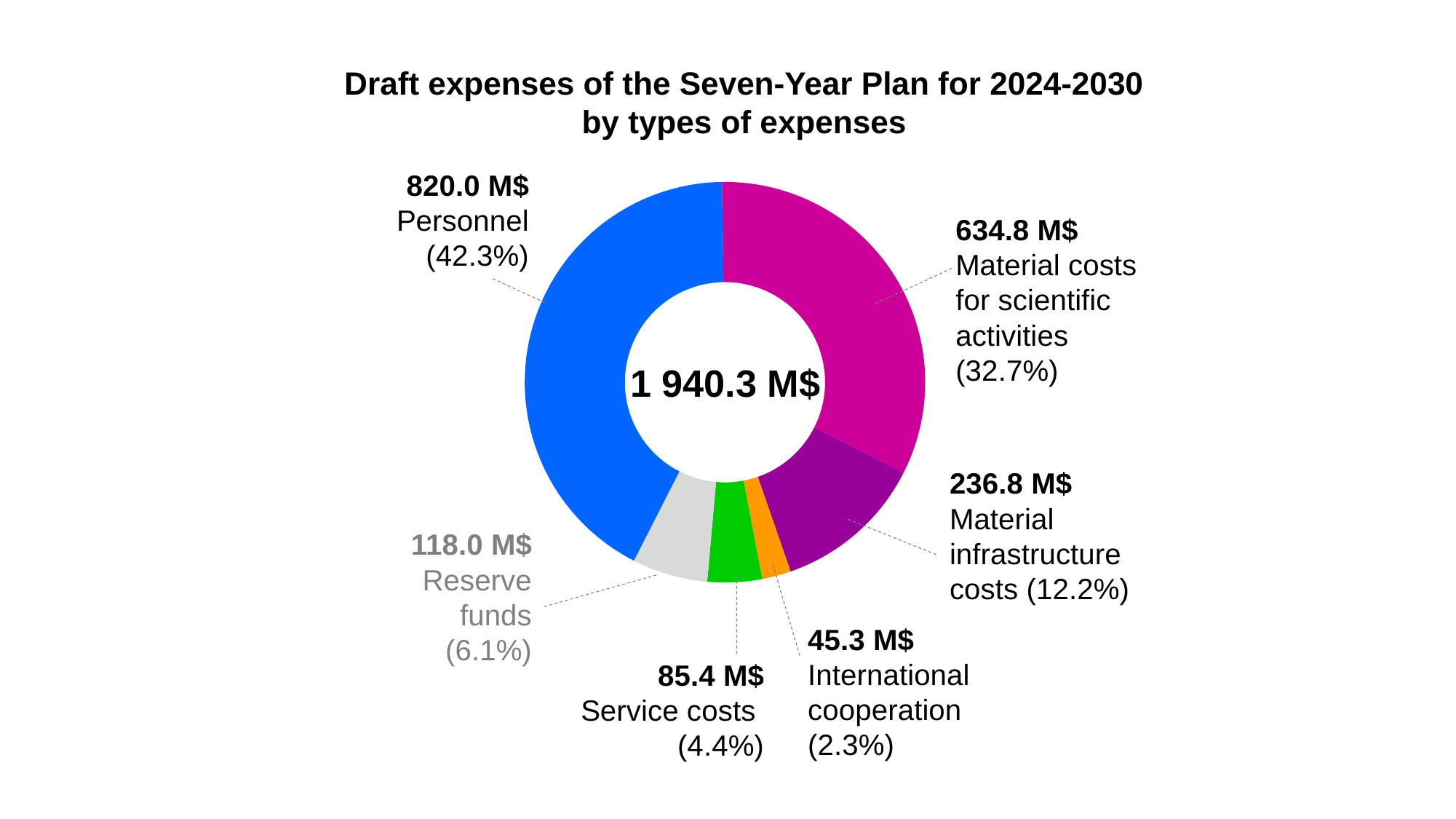
Which is larger, Reserve funds or Service costs? Reserve funds How many categories of expenses are shown in the chart? 6 Which category has the largest share of expenses? Personnel What is the value for Personnel? 820.0 M$ What is the difference between Personnel and Material costs for scientific activities? 185.2 M$ Which category has the smallest share of expenses? International cooperation What is the value for International cooperation? 45.3 M$ What is the value for Material costs for scientific activities? 634.8 M$ What total value is shown in the centre of the chart? 1 940.3 M$ What share of the total do Service costs represent? 4.4% What is the value for Reserve funds? 118.0 M$ What share of the total do Material infrastructure costs represent? 12.2%